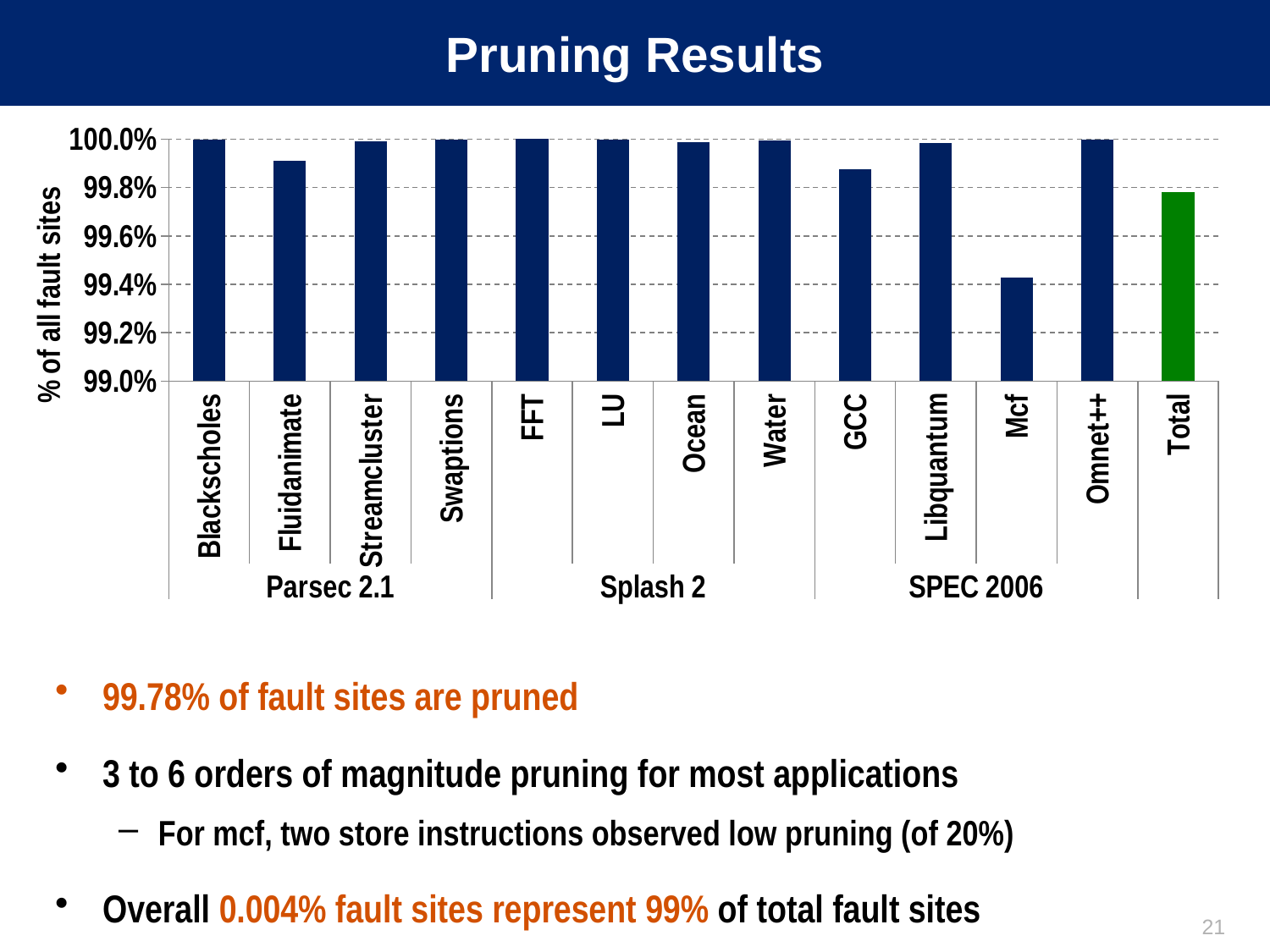
Is the value for Mcf greater or less than 99.2%? greater Which bar is coloured green rather than dark blue? Total Which is larger, the value for GCC or the value for Mcf? GCC Is the value for Total greater or less than 99.6%? greater Is the value for GCC greater or less than 99.8%? greater What kind of chart is shown on the slide? bar chart What is the label of the y axis? % of all fault sites Which application has the lowest percentage of fault sites pruned? Mcf Which benchmark suite group does Mcf belong to on the x axis? SPEC 2006 Which is larger, the value for Total or the value for Mcf? Total How many bars are plotted in the chart? 13